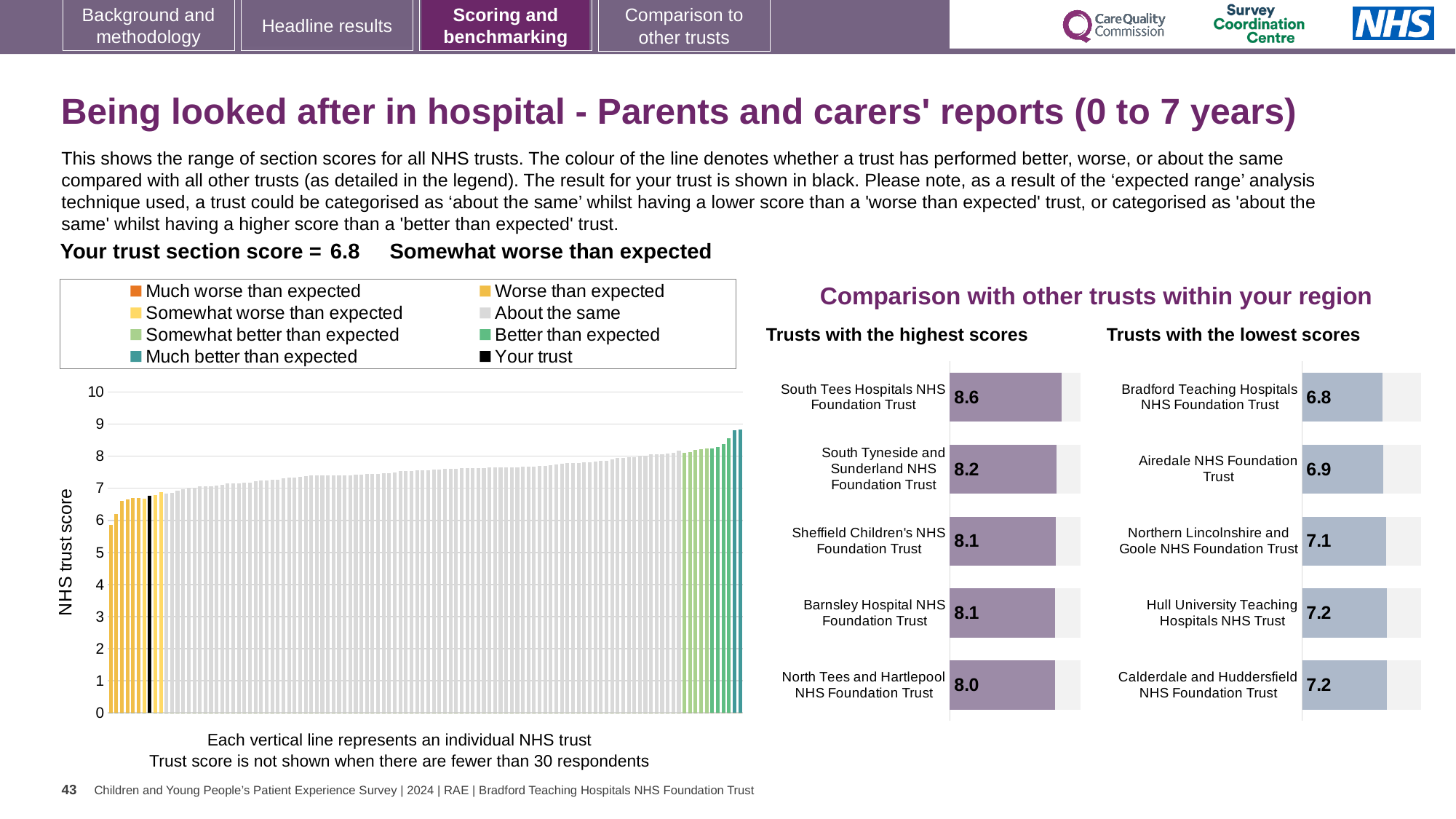
In the 'Trusts with the highest scores' chart, what is the score for South Tees Hospitals NHS Foundation Trust? 8.6 In the large chart on the left, do the bar values rise or fall from left to right? Rise In the 'Trusts with the highest scores' chart, how many trusts are listed? 5 In the 'Trusts with the lowest scores' chart, what is the difference between the scores of Northern Lincolnshire and Goole NHS Foundation Trust and Bradford Teaching Hospitals NHS Foundation Trust? 0.3 What is the y-axis label of the large chart on the left? NHS trust score In the 'Trusts with the lowest scores' chart, which has the higher score: Hull University Teaching Hospitals NHS Trust or Airedale NHS Foundation Trust? Hull University Teaching Hospitals NHS Trust In the 'Trusts with the lowest scores' chart, what is the score for Airedale NHS Foundation Trust? 6.9 In the 'Trusts with the highest scores' chart, which trust has the lowest score shown? North Tees and Hartlepool NHS Foundation Trust In the 'Trusts with the highest scores' chart, what is the difference between the scores of South Tees Hospitals NHS Foundation Trust and North Tees and Hartlepool NHS Foundation Trust? 0.6 In the 'Trusts with the lowest scores' chart, which trust has the lowest score? Bradford Teaching Hospitals NHS Foundation Trust What kind of chart is the large chart on the left showing all NHS trust scores? Bar chart In the large chart on the left, is the value for the black 'Your trust' bar greater or less than 7? less